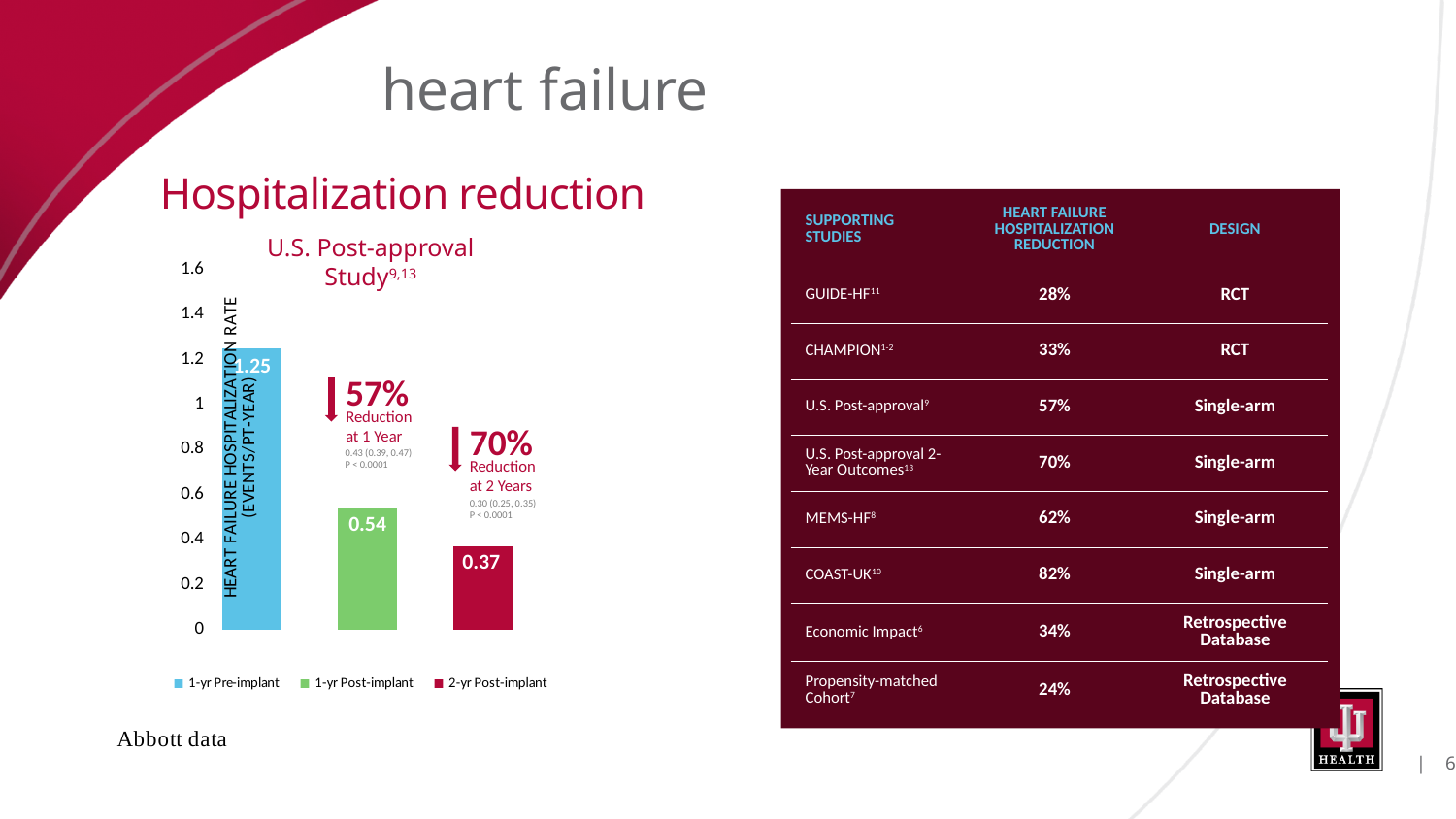
What is the difference between the 1-yr Pre-implant and 1-yr Post-implant hospitalization rates in the chart? 0.71 Which bar in the U.S. Post-approval Study chart has the lowest hospitalization rate? 2-yr Post-implant What is the heart failure hospitalization rate for 2-yr Post-implant in the U.S. Post-approval Study chart? 0.37 How many bars are plotted in the U.S. Post-approval Study chart? 3 Which bar in the U.S. Post-approval Study chart has the highest hospitalization rate? 1-yr Pre-implant What is the difference between the 1-yr Post-implant and 2-yr Post-implant hospitalization rates in the chart? 0.17 What is the heart failure hospitalization rate for 1-yr Pre-implant in the U.S. Post-approval Study chart? 1.25 How many series does the legend of the U.S. Post-approval Study chart list? 3 What is the heart failure hospitalization rate for 1-yr Post-implant in the U.S. Post-approval Study chart? 0.54 Is the hospitalization rate for 1-yr Post-implant larger or smaller than that for 2-yr Post-implant? larger What kind of chart is the U.S. Post-approval Study chart? bar chart Is the value for 1-yr Pre-implant greater or less than 1.2? greater